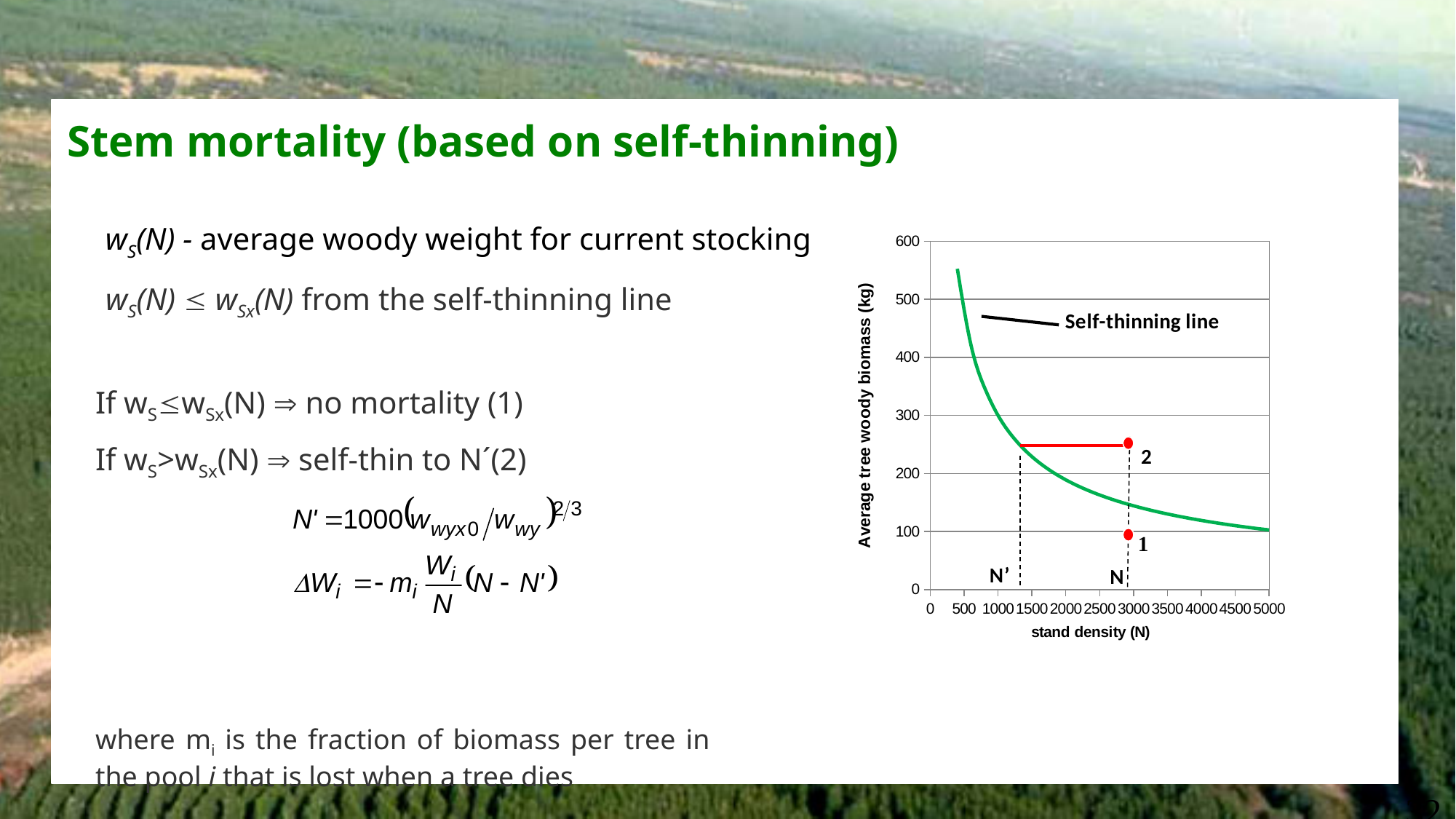
Is the value of the self-thinning line at a stand density of 500 greater or less than 400? greater Is the value of the self-thinning line at a stand density of 3000 greater or less than 200? less Does the self-thinning line rise or fall as stand density increases? fall Which of the two marked points, 1 or 2, has the higher average tree woody biomass? 2 What is the highest value shown on the y axis of the chart? 600 Is the average tree woody biomass at point 2 greater or less than 300? less What kind of chart is shown on the slide? line chart What is the label of the y axis of the chart? Average tree woody biomass (kg) What is the label of the x axis of the chart? stand density (N)